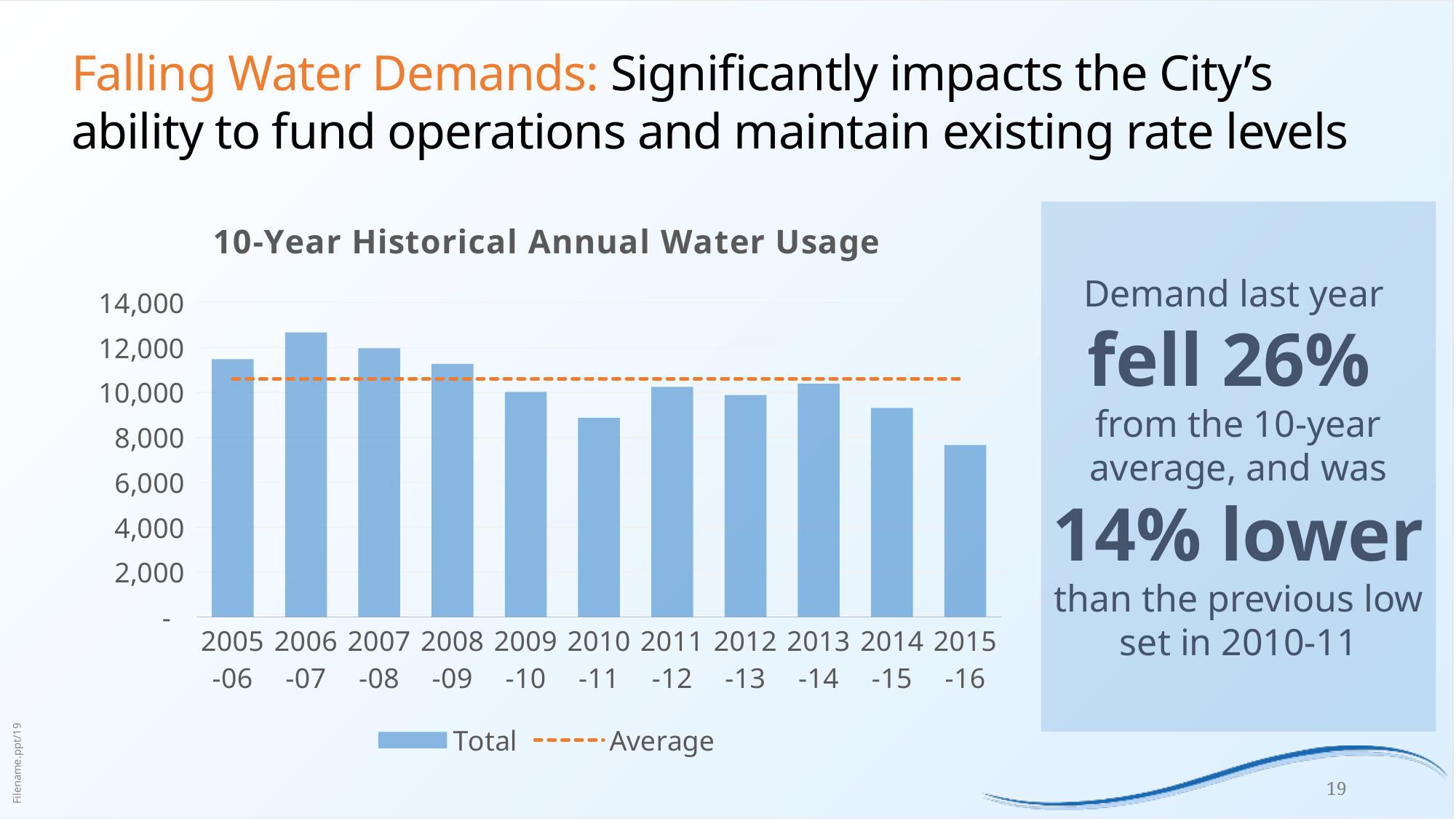
How many fiscal years are shown on the x axis of the water usage chart? 11 Is the total water usage for 2014-15 greater or less than 10,000? less Which fiscal year has higher total water usage, 2007-08 or 2014-15? 2007-08 What kind of chart is used to show the 10-Year Historical Annual Water Usage? Bar chart Which fiscal year has the highest total water usage? 2006-07 Which fiscal year has the lowest total water usage? 2015-16 How many series does the legend of the water usage chart list? 2 Is the total water usage for 2005-06 greater or less than 10,000? greater Is the total water usage for 2006-07 greater or less than 12,000? greater Overall, does total water usage rise or fall from 2005-06 to 2015-16? Fall What does the orange dashed line in the water usage chart represent, according to the legend? Average